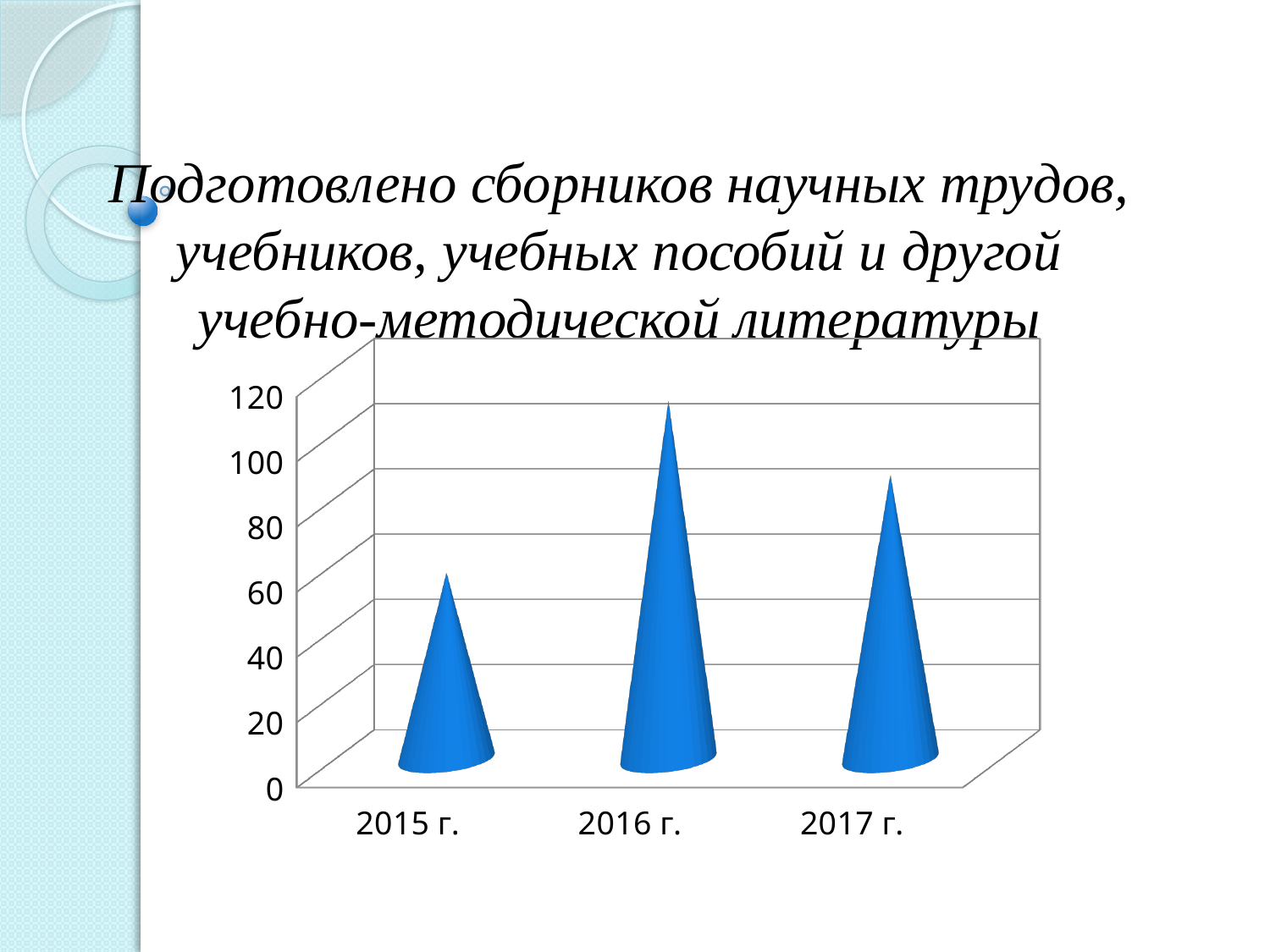
Is the value for 2017 г. greater or less than 120? less Which year has the highest value in the chart? 2016 г. Is the value for 2015 г. greater or less than 80? less How many categories are shown on the x axis of the chart? 3 Which is larger, the value for 2015 г. or the value for 2017 г.? 2017 г. Is the value for 2016 г. greater or less than 80? greater Which is larger, the value for 2016 г. or the value for 2017 г.? 2016 г. What kind of chart is shown on the slide? bar chart Which year has the lowest value in the chart? 2015 г. Does the value rise or fall from 2015 г. to 2016 г.? rise What is the first word of the chart's title on the slide? Подготовлено